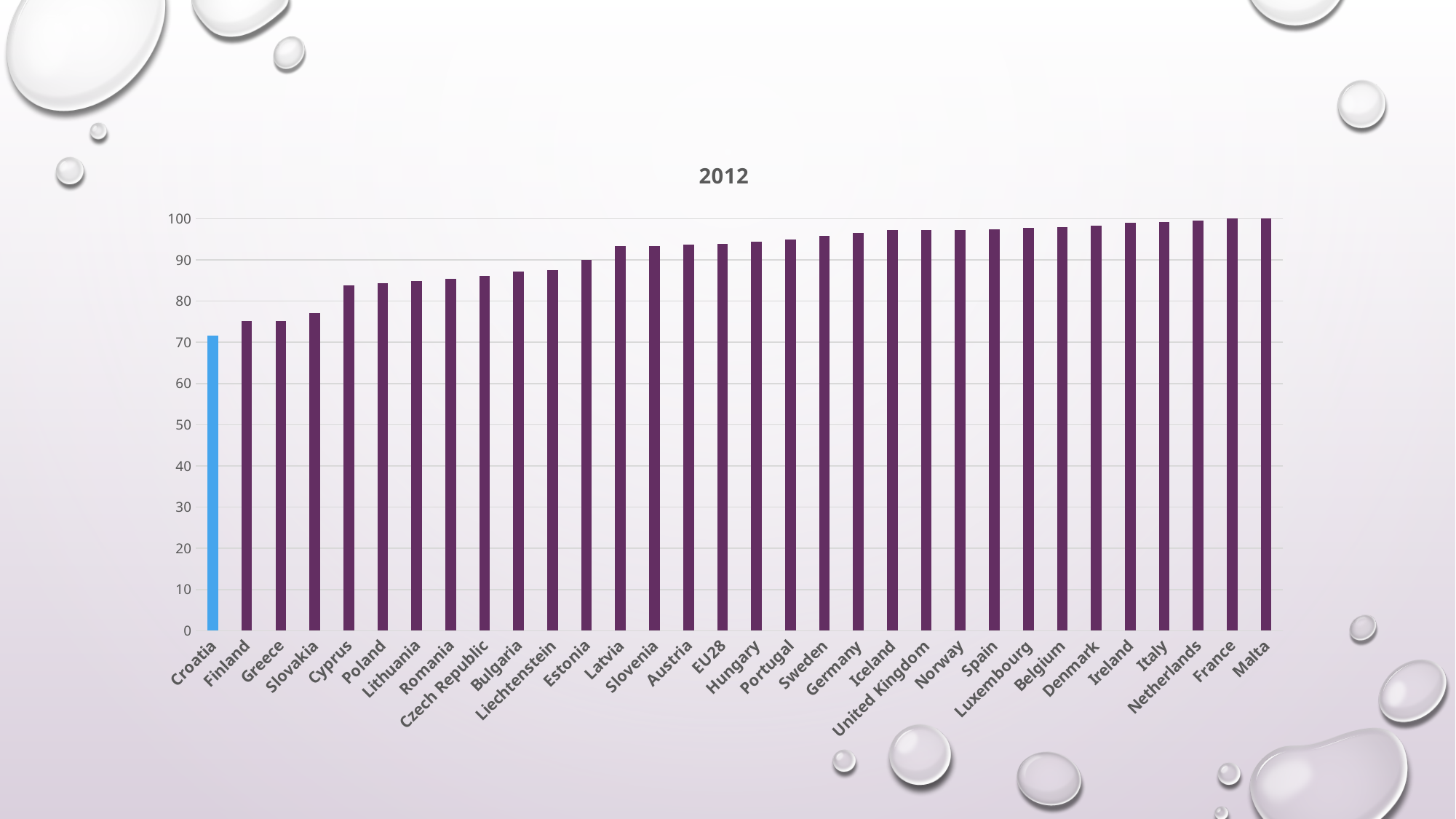
How many countries/categories are shown on the x axis of the chart? 32 Which bar is coloured differently (blue) from the others? Croatia Which is larger, the value for Croatia or the value for Finland? Finland Is the value for Latvia greater or less than 90? greater Is the value for Croatia greater or less than 80? less Is the value for Finland greater or less than 80? less Do the values generally rise or fall from left to right along the x axis? rise What kind of chart is shown on the slide? bar chart Which is larger, the value for Estonia or the value for Latvia? Latvia What is the title of the chart? 2012 Which category has the lowest value in the chart? Croatia